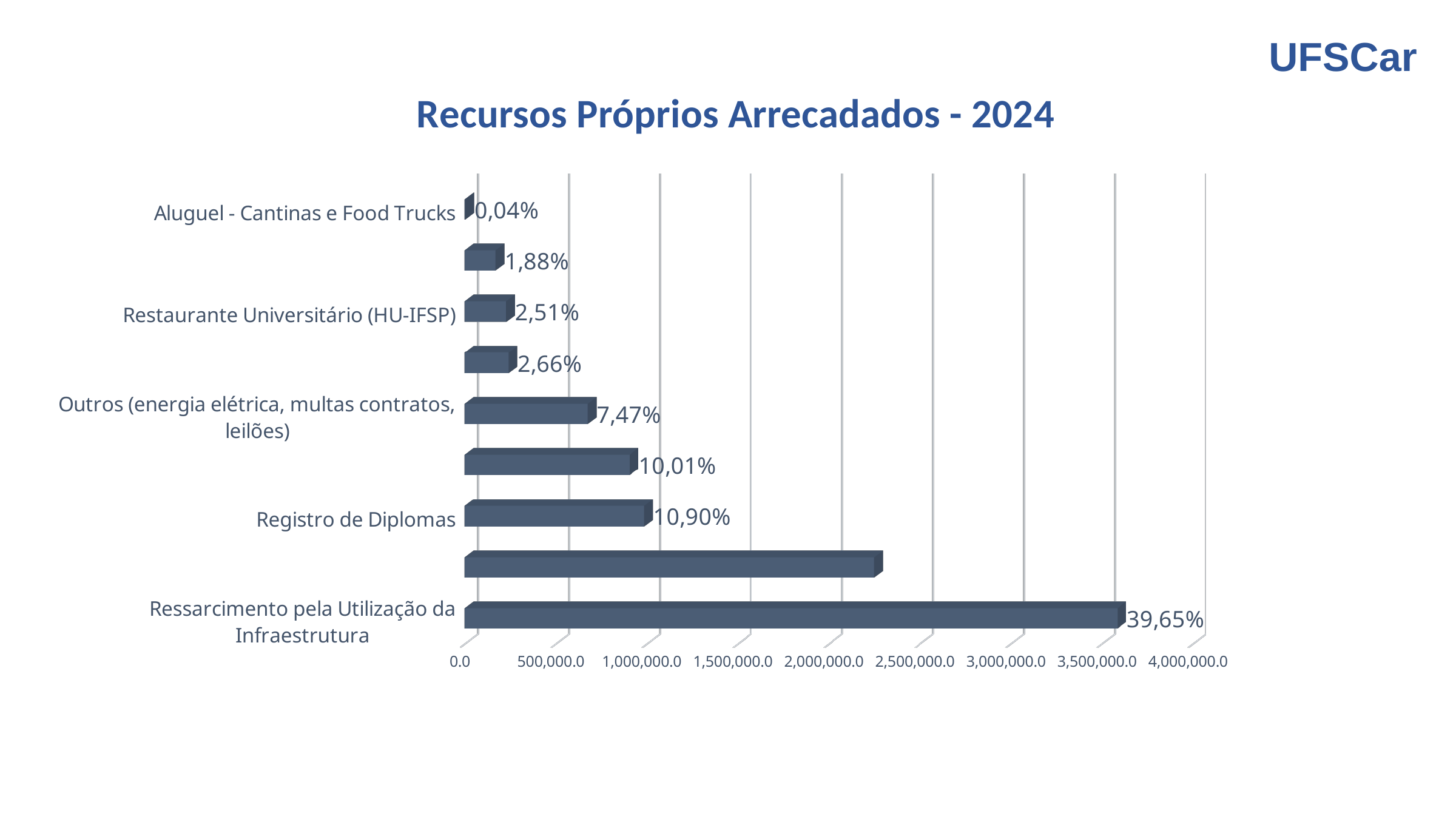
What percentage label is shown for Registro de Diplomas? 10,90% What percentage label is shown for Ressarcimento pela Utilização da Infraestrutura? 39,65% What kind of chart is shown on the slide? bar chart Which is larger, the value for Registro de Diplomas or the value for Outros (energia elétrica, multas contratos, leilões)? Registro de Diplomas What percentage label is shown for Restaurante Universitário (HU-IFSP)? 2,51% What is the difference in percentage points between Ressarcimento pela Utilização da Infraestrutura and Registro de Diplomas? 28,75% What percentage label is shown for Aluguel - Cantinas e Food Trucks? 0,04% Which category has the lowest value? Aluguel - Cantinas e Food Trucks Which category has the highest value? Ressarcimento pela Utilização da Infraestrutura Is the value for Ressarcimento pela Utilização da Infraestrutura greater or less than 3,500,000.0? greater What percentage label is shown for Outros (energia elétrica, multas contratos, leilões)? 7,47% What is the title of the chart? Recursos Próprios Arrecadados - 2024